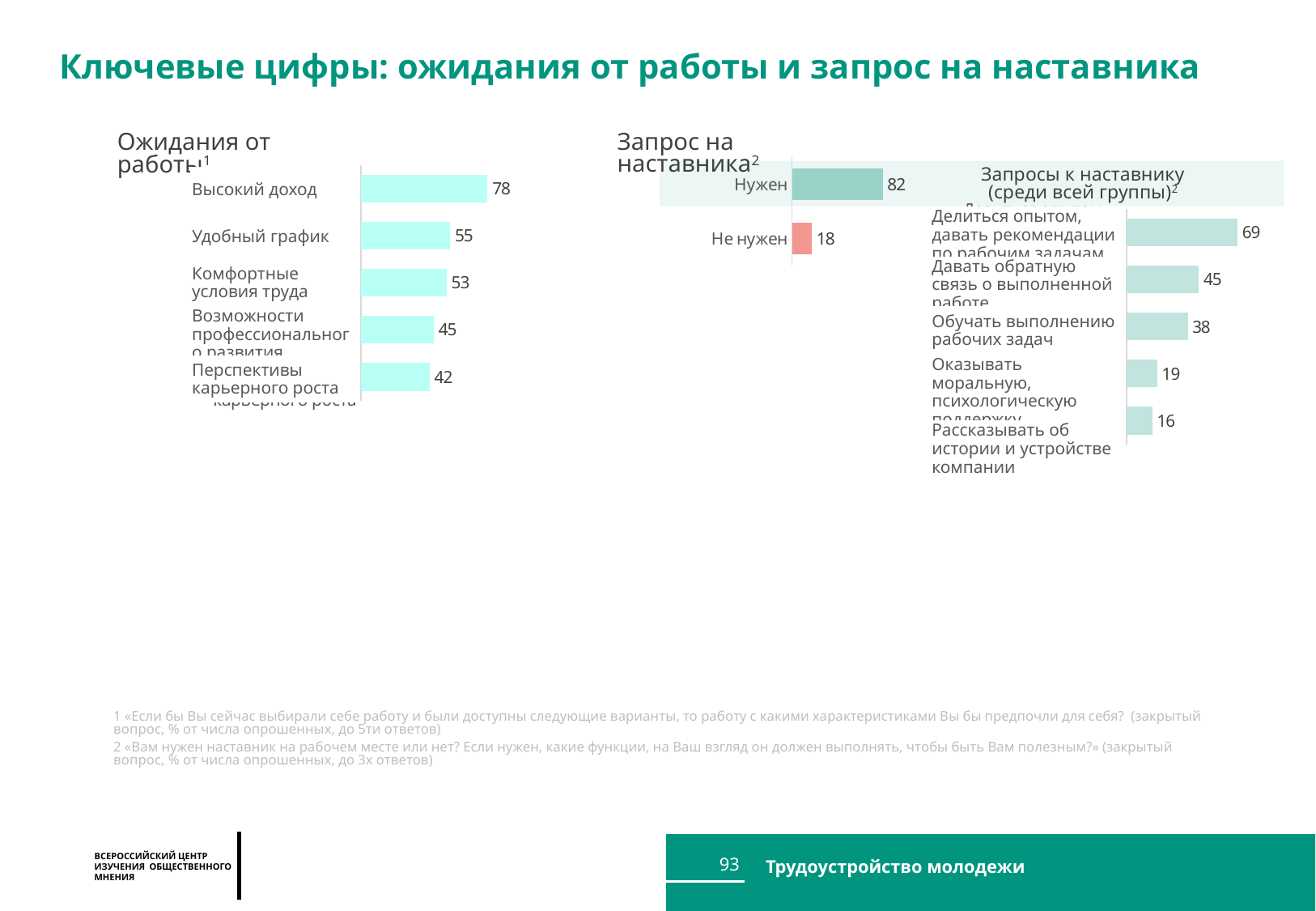
On the chart "Запросы к наставнику (среди всей группы)", what is the difference between "Делиться опытом, давать рекомендации по рабочим задачам" and "Рассказывать об истории и устройстве компании"? 53 On the chart "Ожидания от работы", what is the value for "Высокий доход"? 78 On the chart "Ожидания от работы", which category has the lowest value? Перспективы карьерного роста On the chart "Запросы к наставнику (среди всей группы)", what is the value for "Давать обратную связь о выполненной работе"? 45 What type of chart is "Ожидания от работы"? Bar chart On the chart "Ожидания от работы", how many categories are shown? 5 On the chart "Запросы к наставнику (среди всей группы)", which is larger: "Обучать выполнению рабочих задач" or "Оказывать моральную, психологическую поддержку"? Обучать выполнению рабочих задач On the chart "Запросы к наставнику (среди всей группы)", which category has the highest value? Делиться опытом, давать рекомендации по рабочим задачам On the chart "Запрос на наставника", what is the value for "Нужен"? 82 On the chart "Ожидания от работы", what is the difference between "Высокий доход" and "Удобный график"? 23 On the chart "Запрос на наставника", what is the total of "Нужен" and "Не нужен"? 100 On the chart "Запрос на наставника", what is the value for "Не нужен"? 18